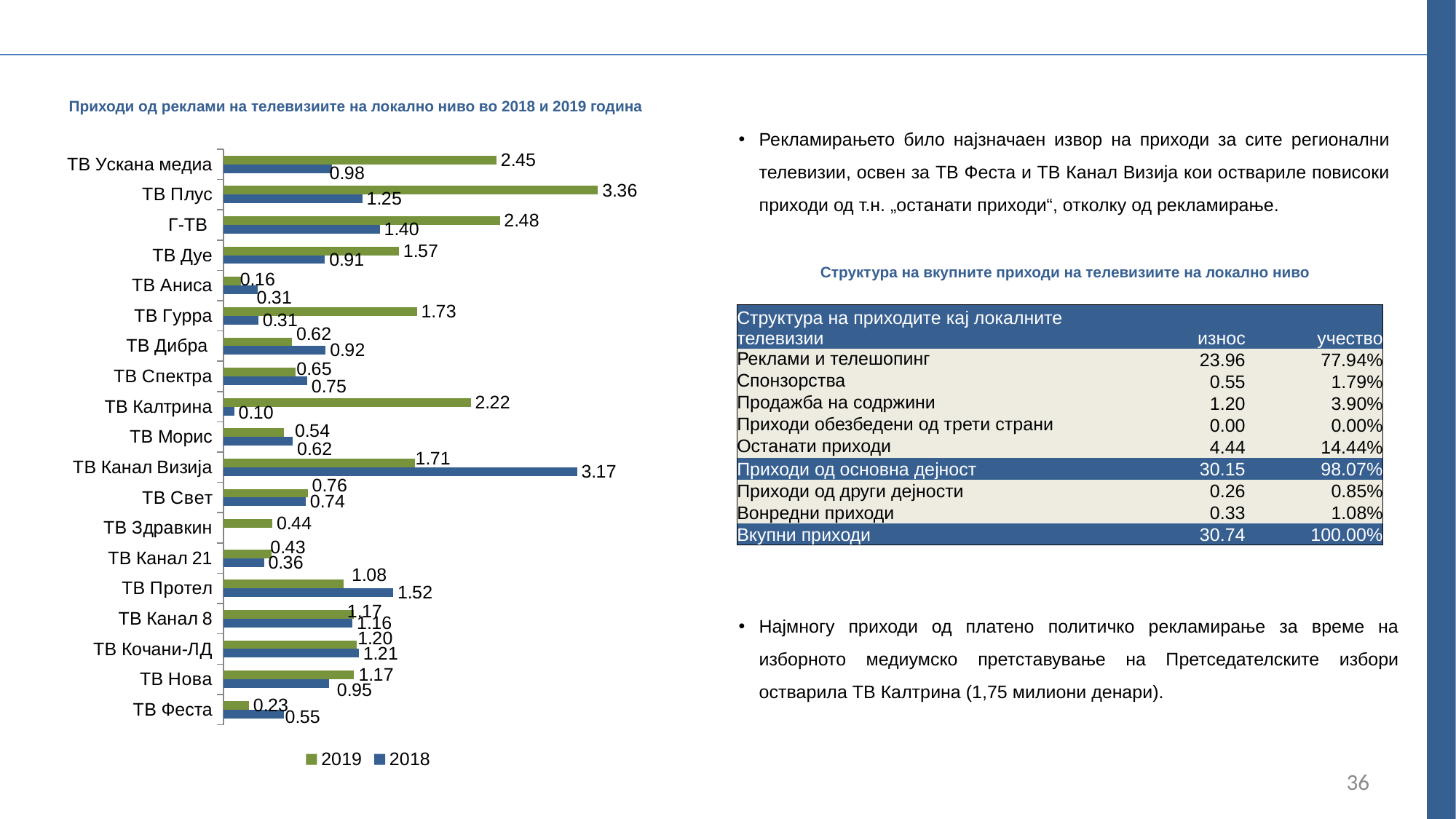
What is the difference between the 2019 and 2018 values for ТВ Плус? 2.11 How many series does the legend list? 2 For ТВ Протел, which year has the larger value, 2019 or 2018? 2018 What kind of chart is shown on the slide? Bar chart How many televisions (categories) are shown in the chart? 19 Which television has the highest 2019 value? ТВ Плус Which television has the highest 2018 value? ТВ Канал Визија What is the 2018 value for ТВ Канал Визија? 3.17 What is the 2019 value for ТВ Плус? 3.36 What is the title of the chart? Приходи од реклами на телевизиите на локално ниво во 2018 и 2019 година What is the 2018 value for ТВ Калтрина? 0.10